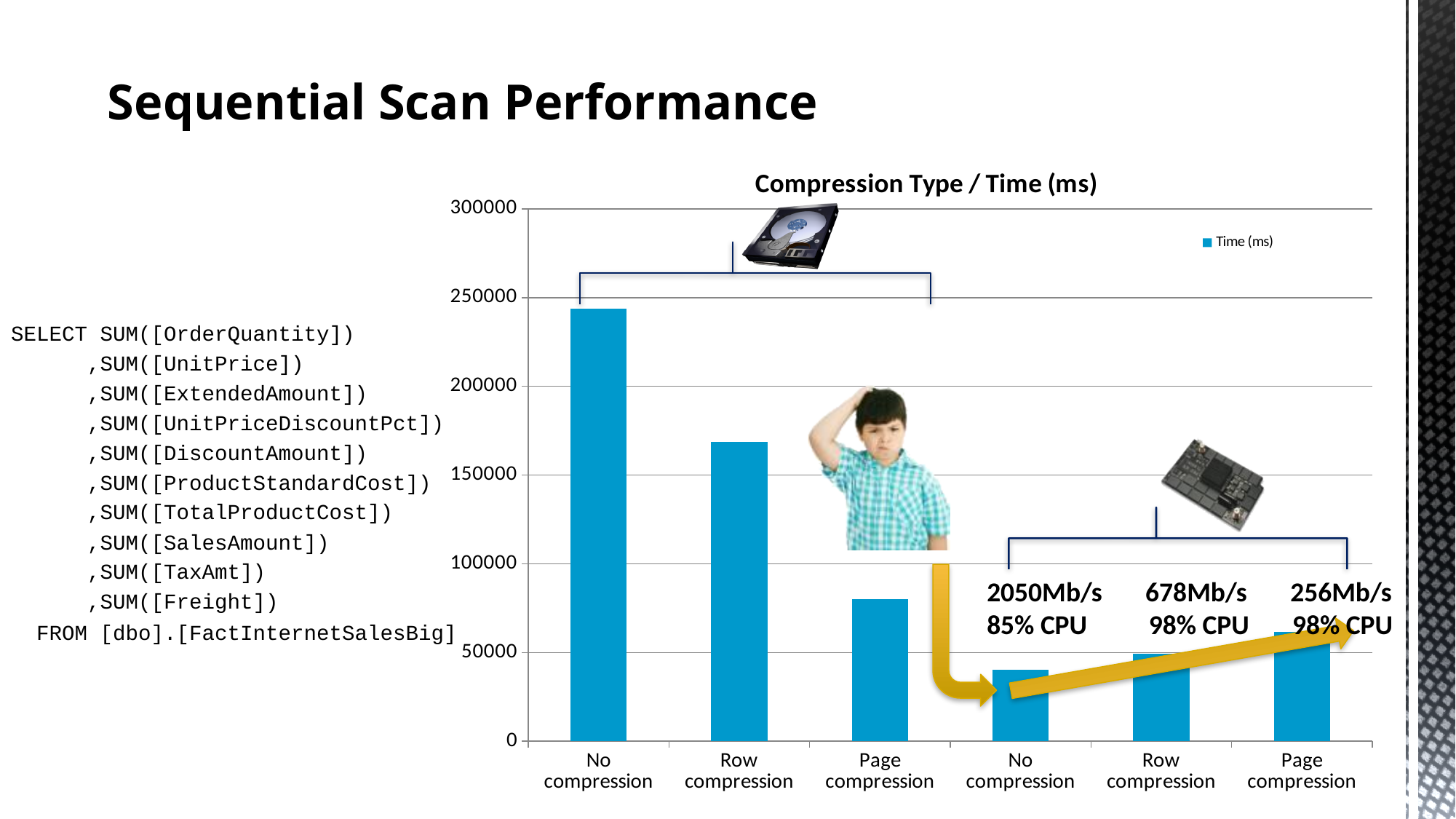
Is the value of the leftmost Page compression bar (third bar) greater or less than 100000? less Is the value of the leftmost No compression bar greater or less than 200000? greater What is the name of the series shown in the legend? Time (ms) What is the title of the chart? Compression Type / Time (ms) Which bar is the shortest in the chart? the No compression bar in the right-hand group (fourth bar) Which bar is the tallest in the chart? the leftmost No compression bar Do the values rise or fall across the first three bars from left to right? fall How many bars are plotted in the chart? 6 What kind of chart is shown on the slide? bar chart Which is larger, the leftmost Row compression bar or the leftmost Page compression bar? Row compression How many series does the chart legend list? 1 Is the value of the leftmost Row compression bar (second bar) greater or less than 150000? greater